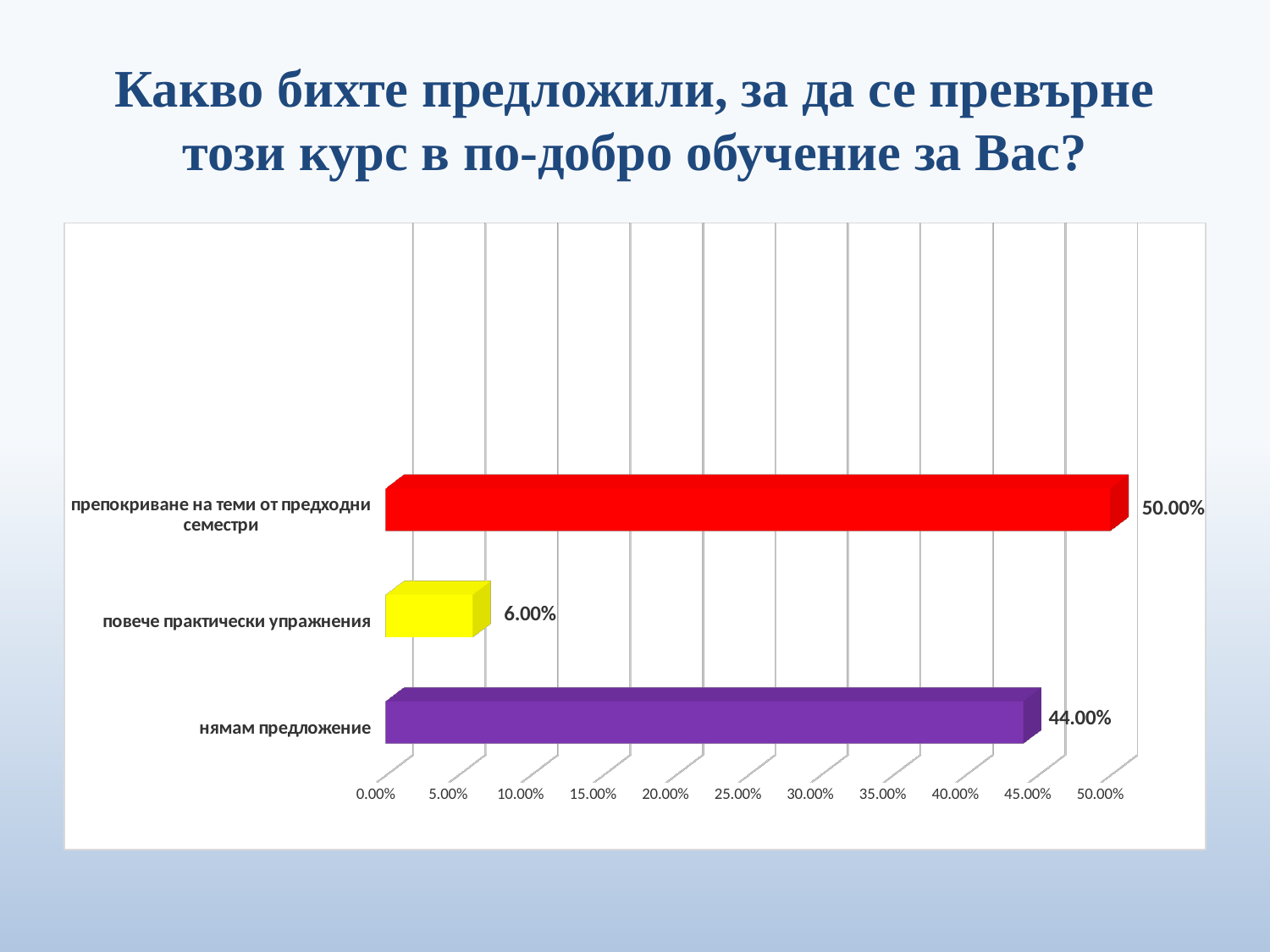
Which is larger: the value for "нямам предложение" or the value for "повече практически упражнения"? нямам предложение Is the value for "нямам предложение" greater or less than 40.00%? greater Which category has the highest value? препокриване на теми от предходни семестри What is the value for "нямам предложение"? 44.00% What is the difference between the values for "препокриване на теми от предходни семестри" and "нямам предложение"? 6.00% What is the value for "повече практически упражнения"? 6.00% How many categories are shown in the chart? 3 What colour is the bar for "повече практически упражнения"? yellow What is the difference between the values for "нямам предложение" and "повече практически упражнения"? 38.00% What kind of chart is shown on the slide? bar chart Which category has the lowest value? повече практически упражнения What is the value for "препокриване на теми от предходни семестри"? 50.00%